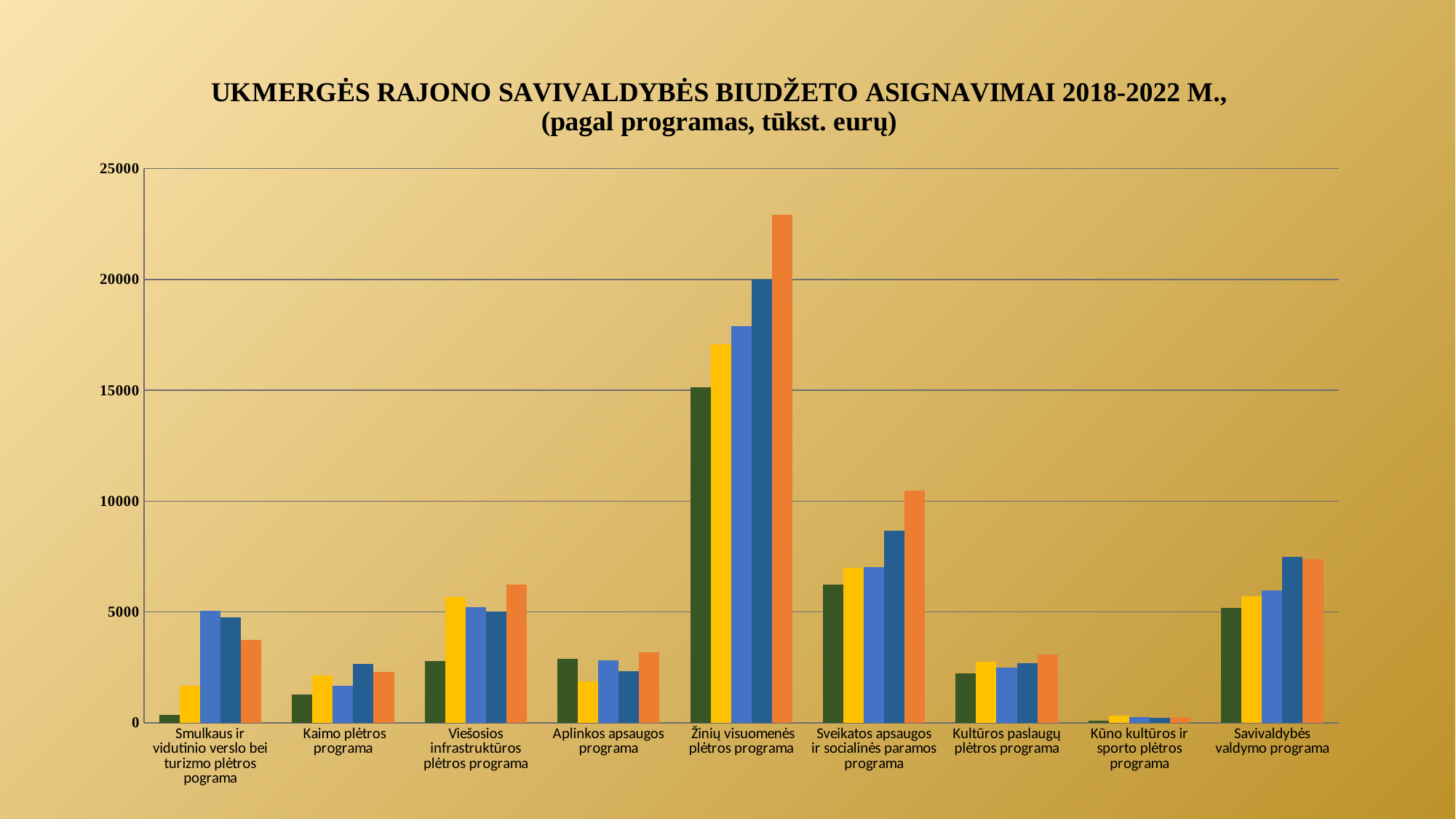
Which programme has the tallest bars in the chart? Žinių visuomenės plėtros programa Which programme has the lowest bars in the chart? Kūno kultūros ir sporto plėtros programa Do the bars for Žinių visuomenės plėtros programa rise or fall from left to right? rise Which has the larger orange bar: Žinių visuomenės plėtros programa or Savivaldybės valdymo programa? Žinių visuomenės plėtros programa Is the value of the dark green bar for Kaimo plėtros programa greater or less than 5000? less What kind of chart is shown on the slide? bar chart Is the value of the orange bar for Sveikatos apsaugos ir socialinės paramos programa greater or less than 10000? greater How many bars are shown for each programme category? 5 Is the value of the orange bar for Žinių visuomenės plėtros programa greater or less than 20000? greater How many programme categories are shown along the x axis? 9